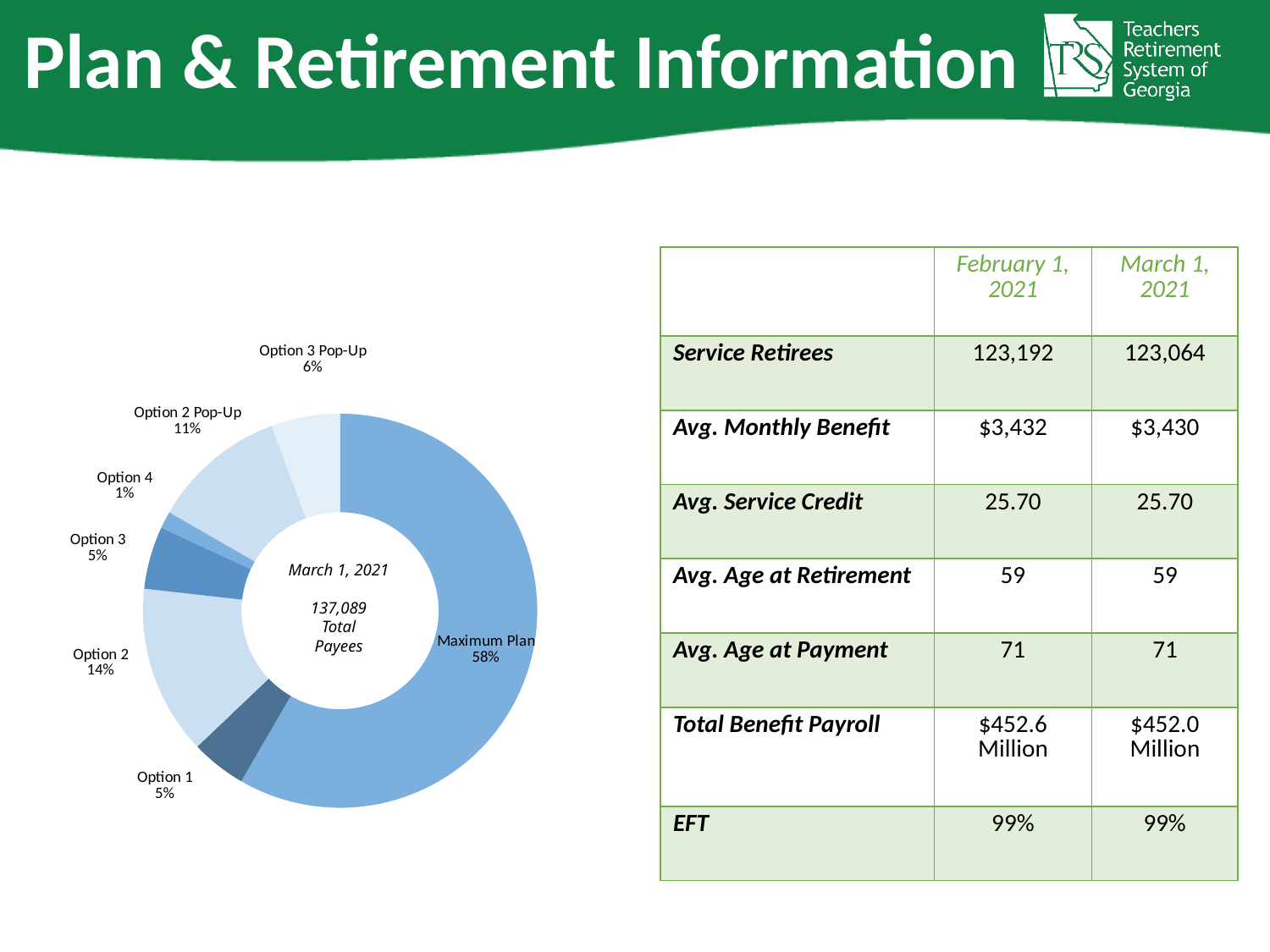
Which slice of the pie chart is the smallest? Option 4 What percentage is shown for Option 3 Pop-Up in the pie chart? 6% What percentage is shown for Option 2 in the pie chart? 14% In the pie chart, what is the difference in percentage points between Option 2 and Option 1? 9 What date is shown in the center of the pie chart? March 1, 2021 What share of the pie chart does the Maximum Plan slice represent? 58% How many slices does the pie chart have? 7 Which slice of the pie chart is the largest? Maximum Plan What kind of chart is shown on the left of the slide? doughnut chart In the pie chart, which is larger: Option 2 Pop-Up or Option 3 Pop-Up? Option 2 Pop-Up What percentage is shown for Option 2 Pop-Up in the pie chart? 11% What total number of payees is shown in the center of the pie chart? 137,089